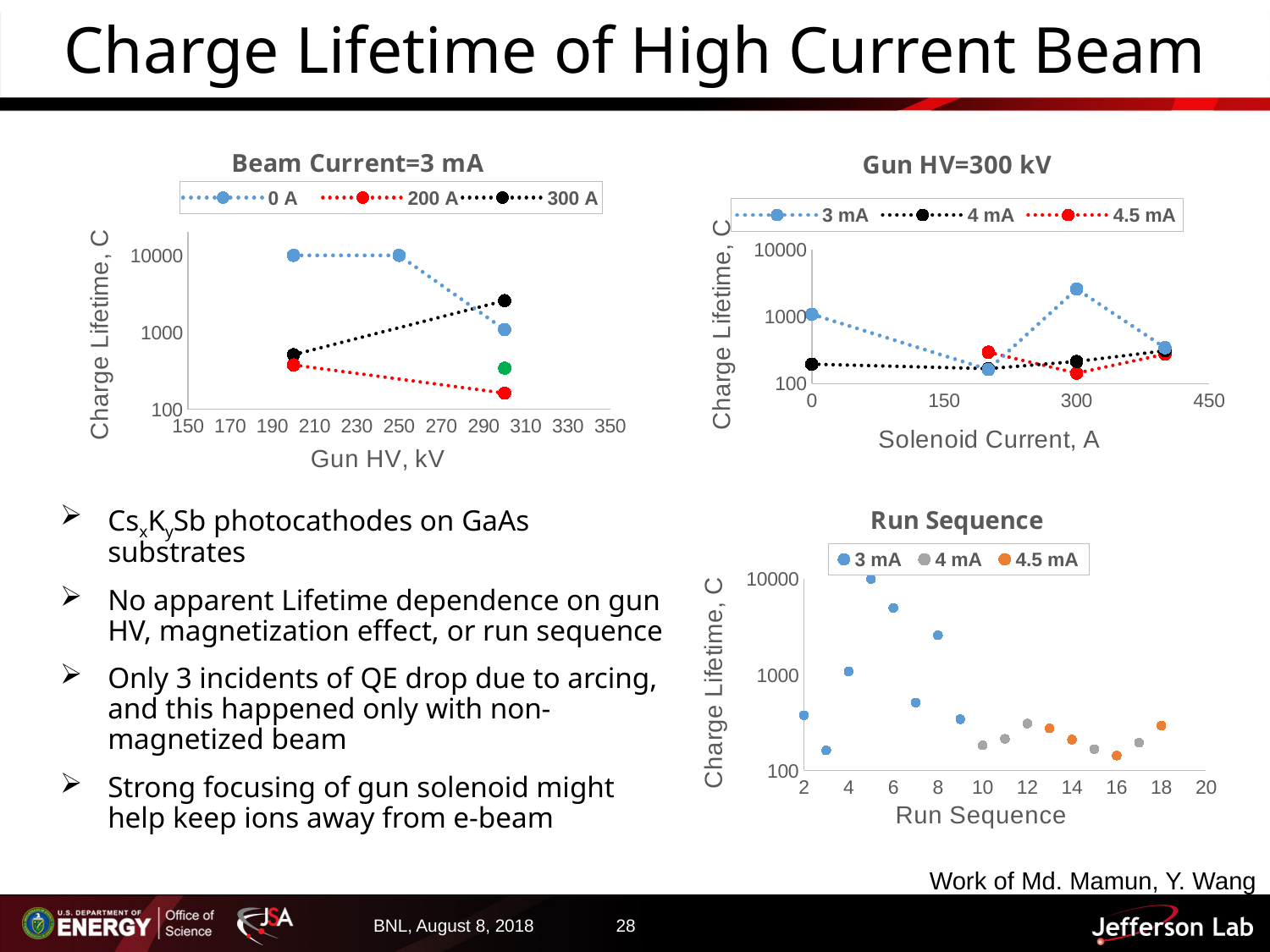
In the 'Beam Current=3 mA' chart, does the 200 A series rise or fall from 200 kV to 300 kV? fall In the 'Beam Current=3 mA' chart, how many series does the legend list? 3 In the 'Beam Current=3 mA' chart, does the 300 A series rise or fall from 200 kV to 300 kV? rise In the 'Run Sequence' chart, how many 4.5 mA points are plotted? 4 In the 'Run Sequence' chart, which series contains the highest charge lifetime value? 3 mA In the 'Gun HV=300 kV' chart, at which solenoid current does the 3 mA series reach its highest value? 300 In the 'Gun HV=300 kV' chart, what is the x-axis title? Solenoid Current, A In the 'Beam Current=3 mA' chart, is the 0 A value at 200 kV greater or less than 1000? greater In the 'Beam Current=3 mA' chart, is the 200 A value at 300 kV greater or less than 1000? less What kind of chart is the 'Run Sequence' chart? scatter chart In the 'Gun HV=300 kV' chart, at a solenoid current of 300 A, which is larger: the 3 mA value or the 4 mA value? 3 mA In the 'Gun HV=300 kV' chart, is the 3 mA value at 300 A greater or less than 1000? greater